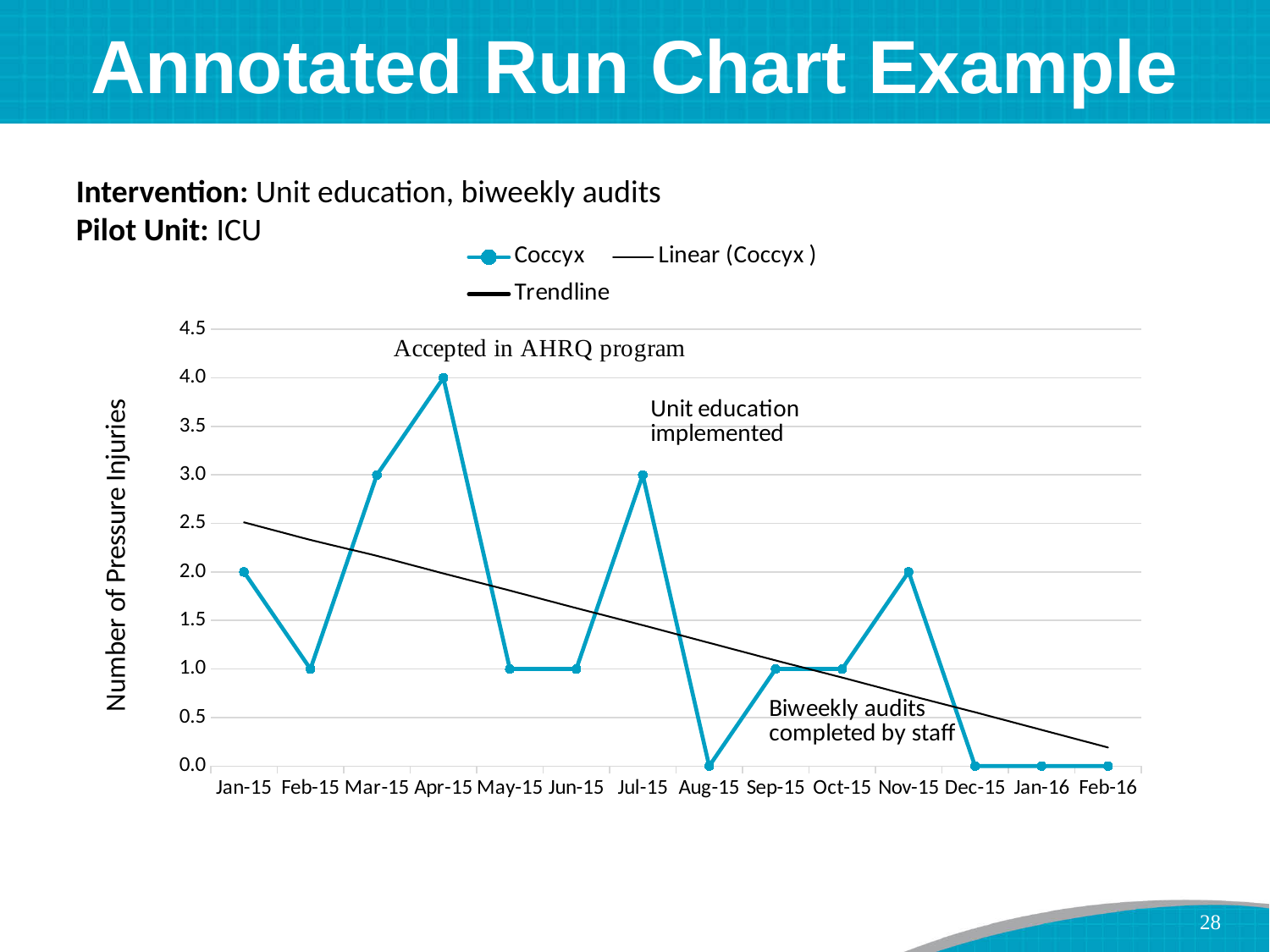
What is the Coccyx value for Nov-15? 2.0 What type of chart is shown on the slide? Line chart How many months are plotted on the x axis? 14 What is the difference between the Coccyx values for Apr-15 and Mar-15? 1.0 What is the Coccyx value for Jul-15? 3.0 What is the lowest Coccyx value plotted on the chart? 0.0 Is the Coccyx value for Feb-15 greater or less than 1.5? less What is the Coccyx value for Apr-15? 4.0 Which month has the highest Coccyx value? Apr-15 How many entries does the legend list? 3 What is the title of the vertical axis? Number of Pressure Injuries Which month has the larger Coccyx value, Mar-15 or Nov-15? Mar-15